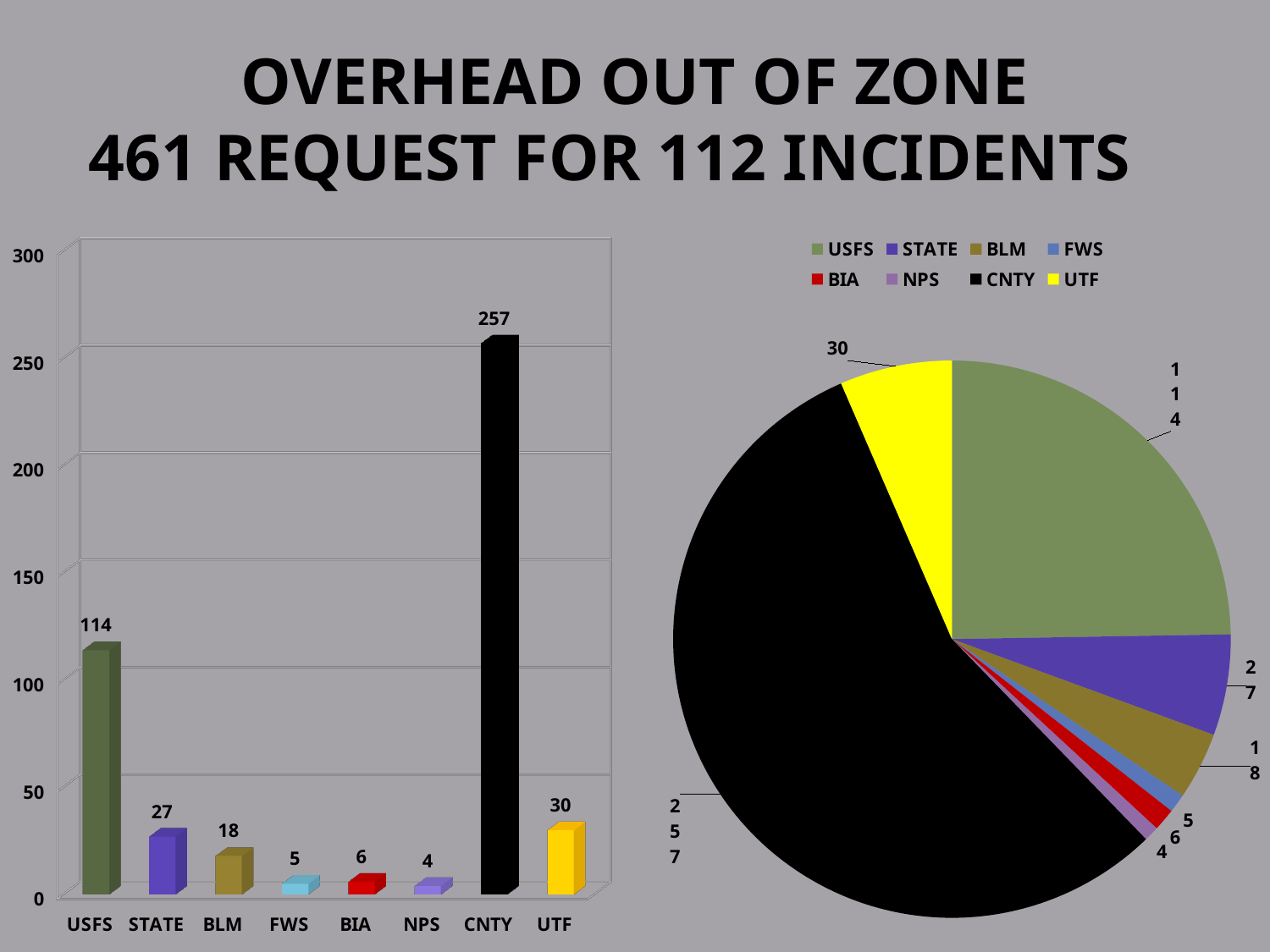
How many categories are shown on the x axis of the bar chart on the left? 8 In the bar chart on the left, what is the value for CNTY? 257 How many entries does the legend of the pie chart on the right list? 8 In the bar chart on the left, is the value for USFS greater or less than 100? greater What kind of chart is on the right side of the slide? pie chart In the bar chart on the left, what is the value for USFS? 114 In the bar chart on the left, which category has the highest value? CNTY In the bar chart on the left, what is the difference between the CNTY value and the USFS value? 143 What kind of chart is on the left side of the slide? bar chart In the bar chart on the left, which category has the lowest value? NPS In the pie chart on the right, what colour is the CNTY slice? black In the bar chart on the left, which is larger, the value for STATE or the value for UTF? UTF